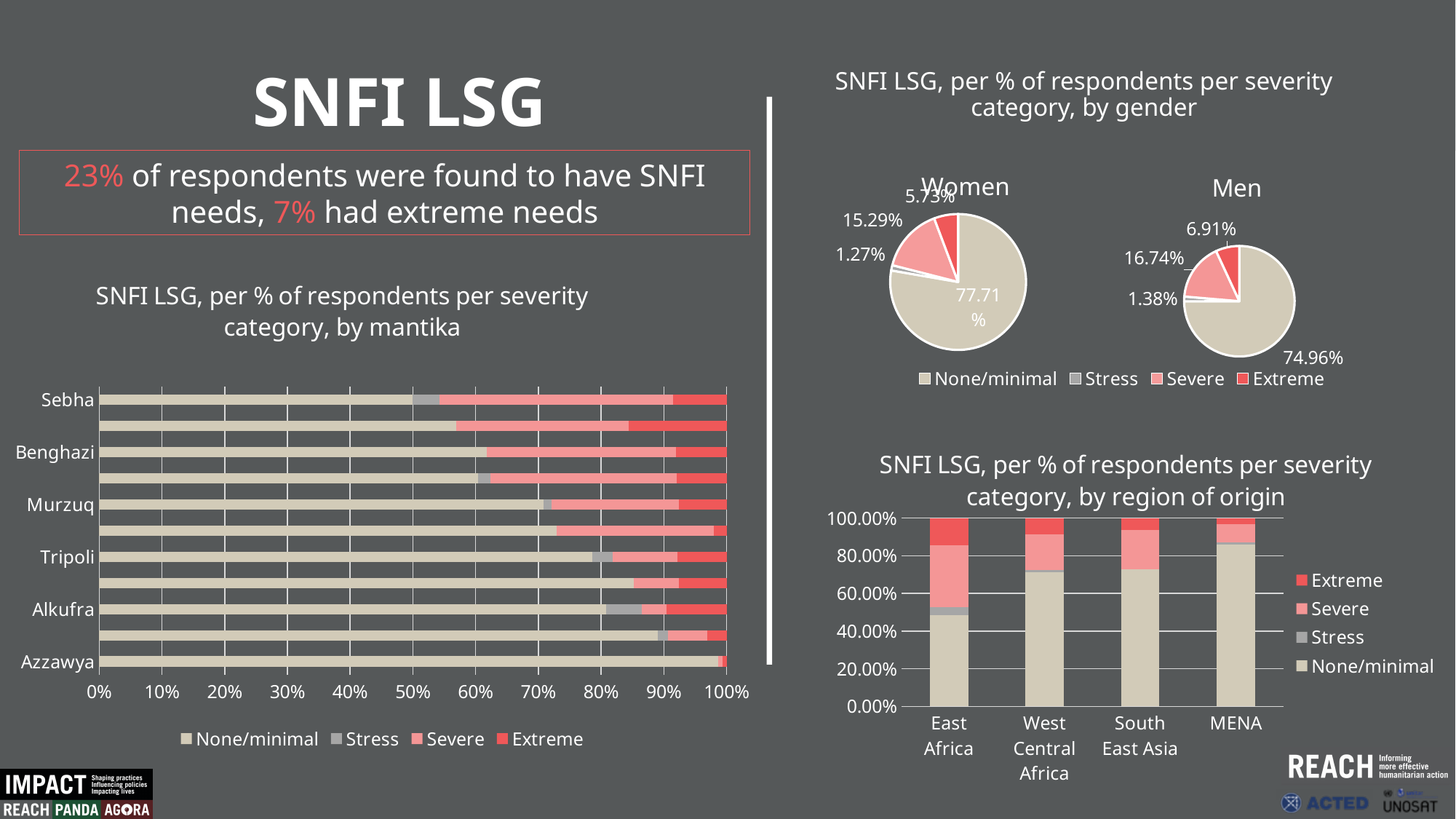
In the chart 'SNFI LSG, per % of respondents per severity category, by region of origin', how many regions are shown on the x axis? 4 What kind of chart is 'SNFI LSG, per % of respondents per severity category, by mantika'? bar chart What is the difference between the Extreme share for Men and the Extreme share for Women in the pie charts? 1.18% In the Men pie chart, what is the share for the Stress category? 1.38% In the Women pie chart, what percentage of respondents fall in the None/minimal category? 77.71% In the Men pie chart, what percentage of respondents fall in the Extreme category? 6.91% In the Women pie chart, what is the share for the Severe category? 15.29% In the chart by region of origin, which region has the highest None/minimal share? MENA In the chart by region of origin, is the None/minimal value for East Africa greater or less than 60.00%? less In the chart by region of origin, how many series does the legend list? 4 Comparing the Women and Men pie charts, which group has the larger Severe share? Men In the chart by mantika, which mantika has the smallest None/minimal share? Sebha